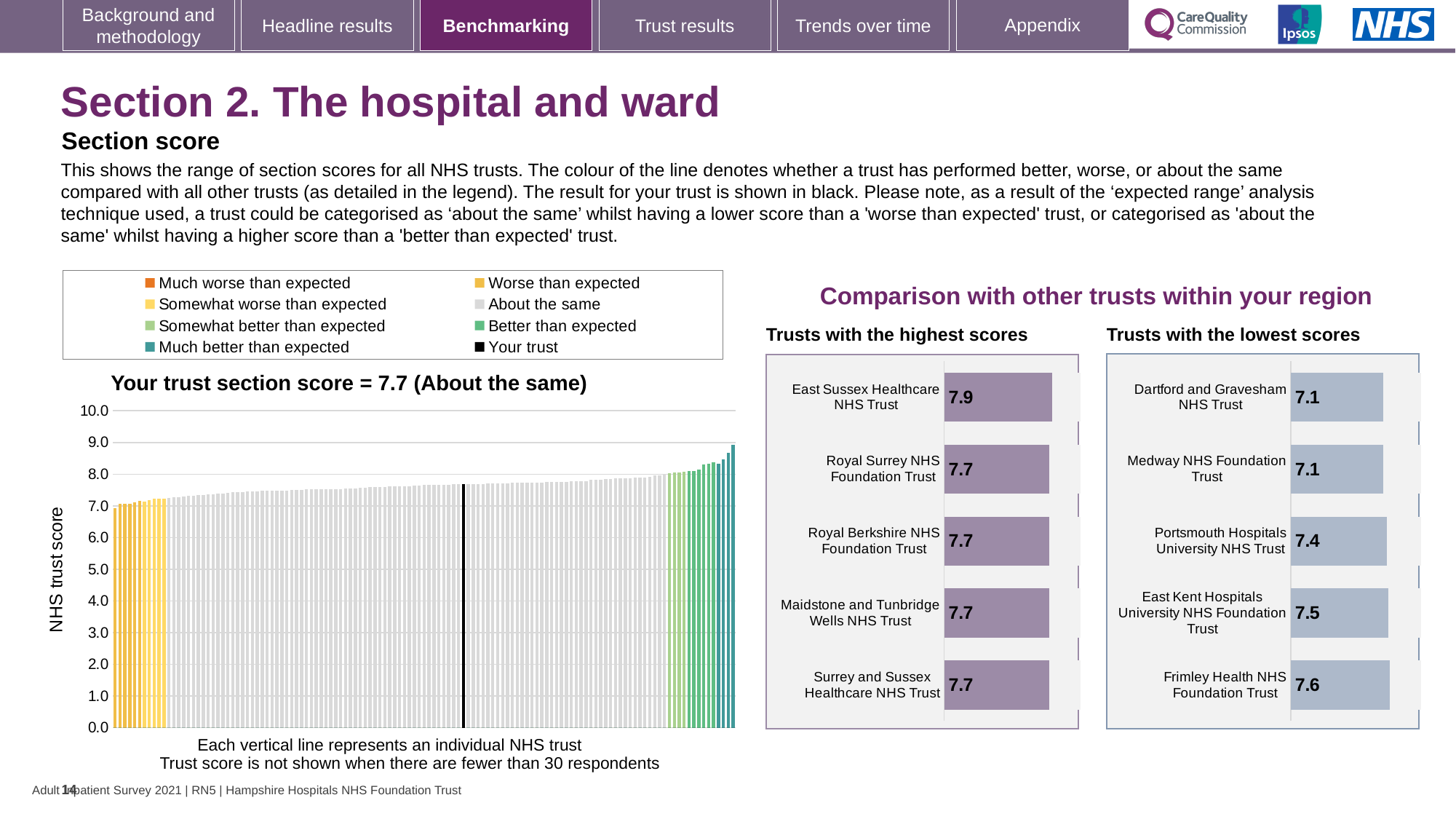
On the 'Trusts with the highest scores' chart, how many trusts are shown? 5 On the 'Your trust section score' chart, do the trust scores rise or fall from left to right? rise On the 'Trusts with the highest scores' chart, what is the score for East Sussex Healthcare NHS Trust? 7.9 On the 'Trusts with the highest scores' chart, what is the difference between the scores of East Sussex Healthcare NHS Trust and Royal Surrey NHS Foundation Trust? 0.2 On the 'Trusts with the lowest scores' chart, which trust has the highest score? Frimley Health NHS Foundation Trust On the 'Trusts with the highest scores' chart, which trust has the highest score? East Sussex Healthcare NHS Trust On the 'Your trust section score' chart, what is the label on the vertical axis? NHS trust score On the 'Your trust section score' chart, what kind of chart is used to show the trust scores? bar chart On the 'Trusts with the lowest scores' chart, which has the larger score, Portsmouth Hospitals University NHS Trust or East Kent Hospitals University NHS Foundation Trust? East Kent Hospitals University NHS Foundation Trust On the 'Your trust section score' chart, what is the section score for your trust? 7.7 On the 'Trusts with the lowest scores' chart, what is the score for Portsmouth Hospitals University NHS Trust? 7.4 On the 'Your trust section score' chart, how many entries does the legend list? 8